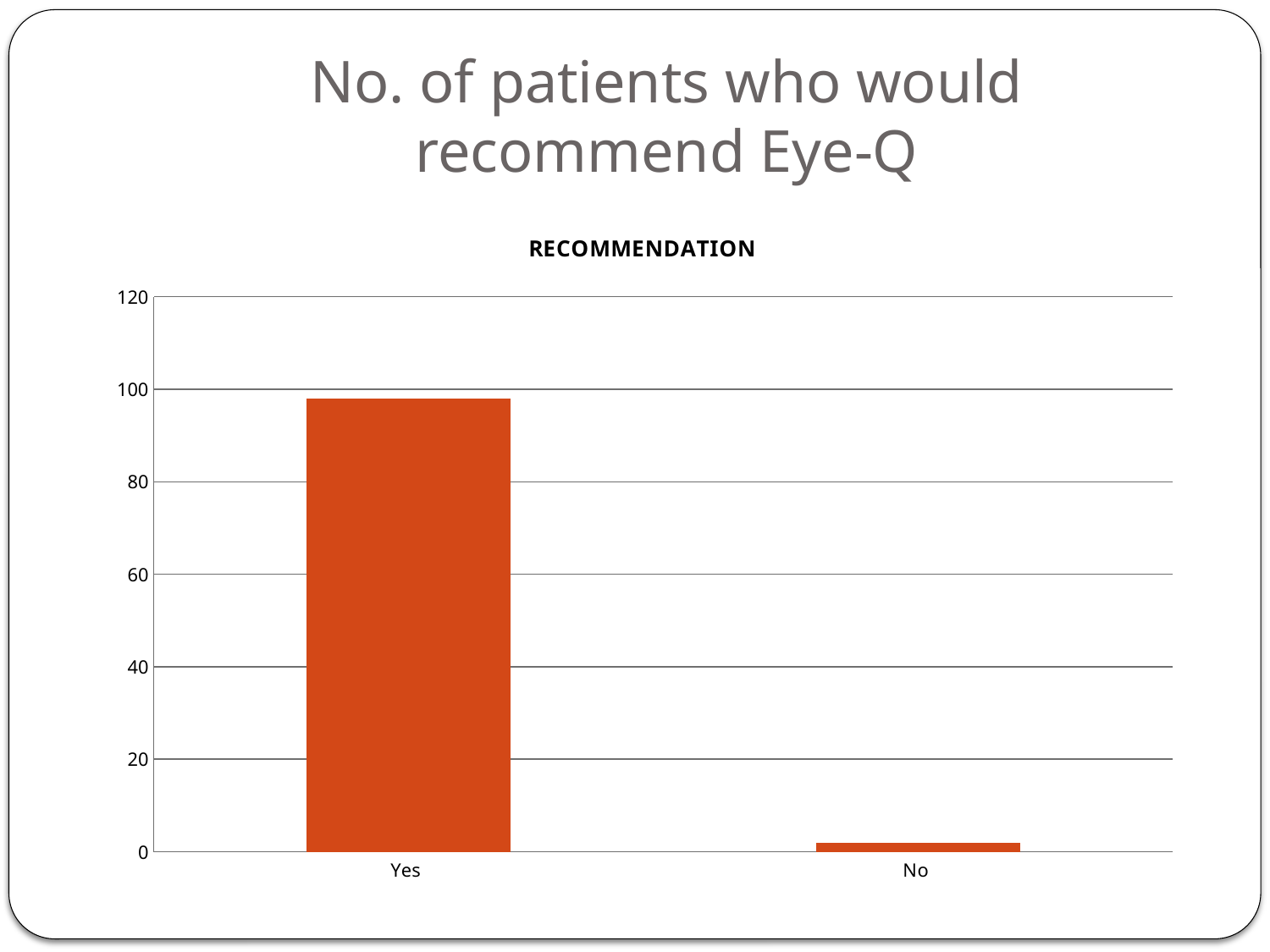
Do the values rise or fall from Yes to No along the x axis? fall Which category has the lowest value? No What is the title of the chart? RECOMMENDATION How many categories are shown on the x axis? 2 Is the value for Yes greater or less than 80? greater Which is larger, the value for Yes or the value for No? Yes Is the value for No greater or less than 20? less Is the value for Yes greater or less than 100? less Which category has the highest value? Yes What is the highest value shown on the y axis? 120 What type of chart is shown on the slide? bar chart